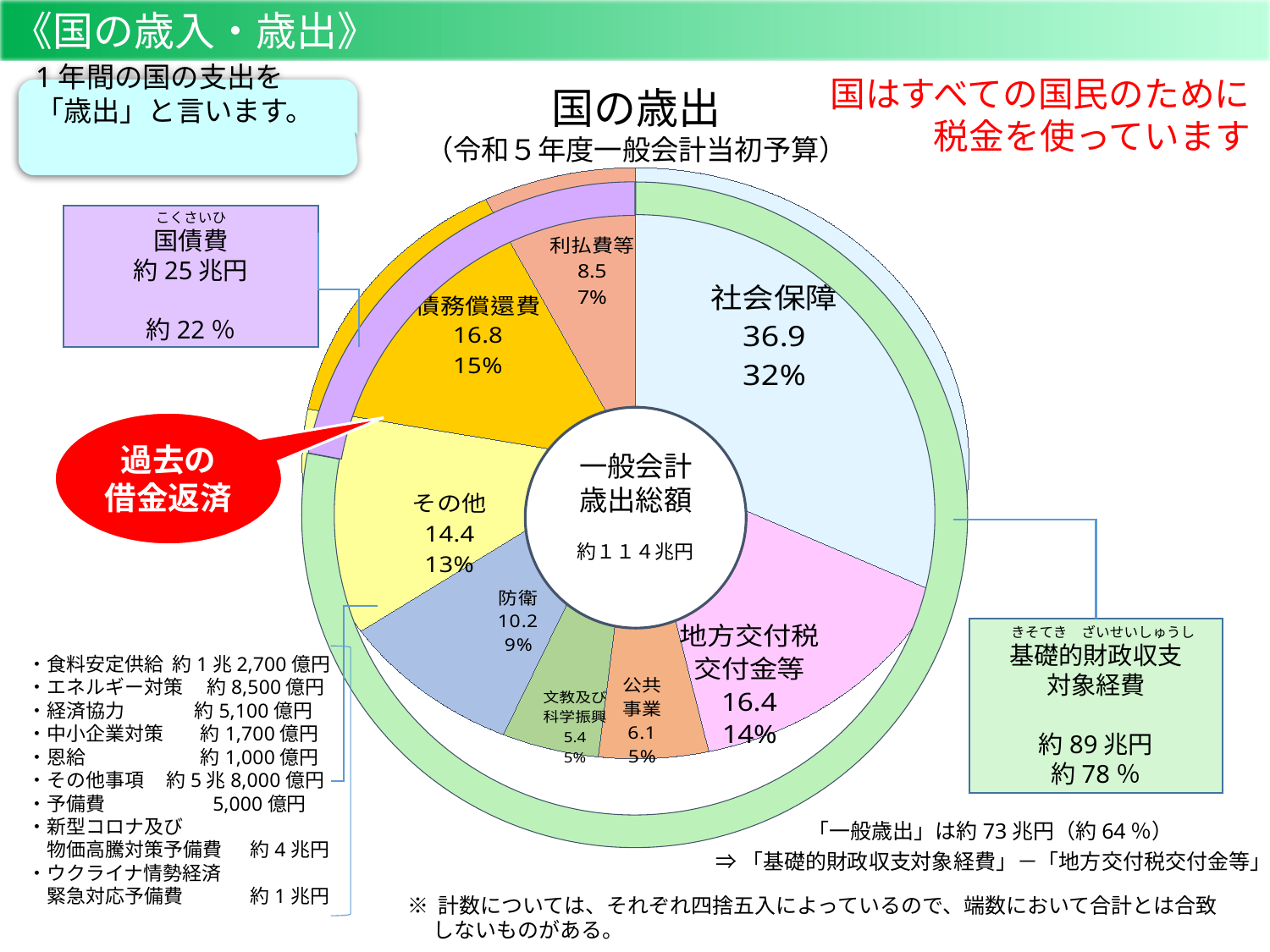
Which is larger, the value for その他 or the value for 防衛? その他 Which category has the largest slice in the chart? 社会保障 Which category has the smallest slice in the chart? 文教及び科学振興 What is the value shown for 防衛? 10.2 What percentage share is shown for 債務償還費? 15% What total amount is shown in the centre of the chart for 一般会計歳出総額? 約114兆円 How many categories (slices) does the chart have? 8 What is the value shown for 地方交付税交付金等? 16.4 What is the value shown for 社会保障 in the 国の歳出 chart? 36.9 What is the difference between the values for 債務償還費 and 利払費等? 8.3 What kind of chart is shown on the slide? pie chart What percentage share is shown for 社会保障? 32%